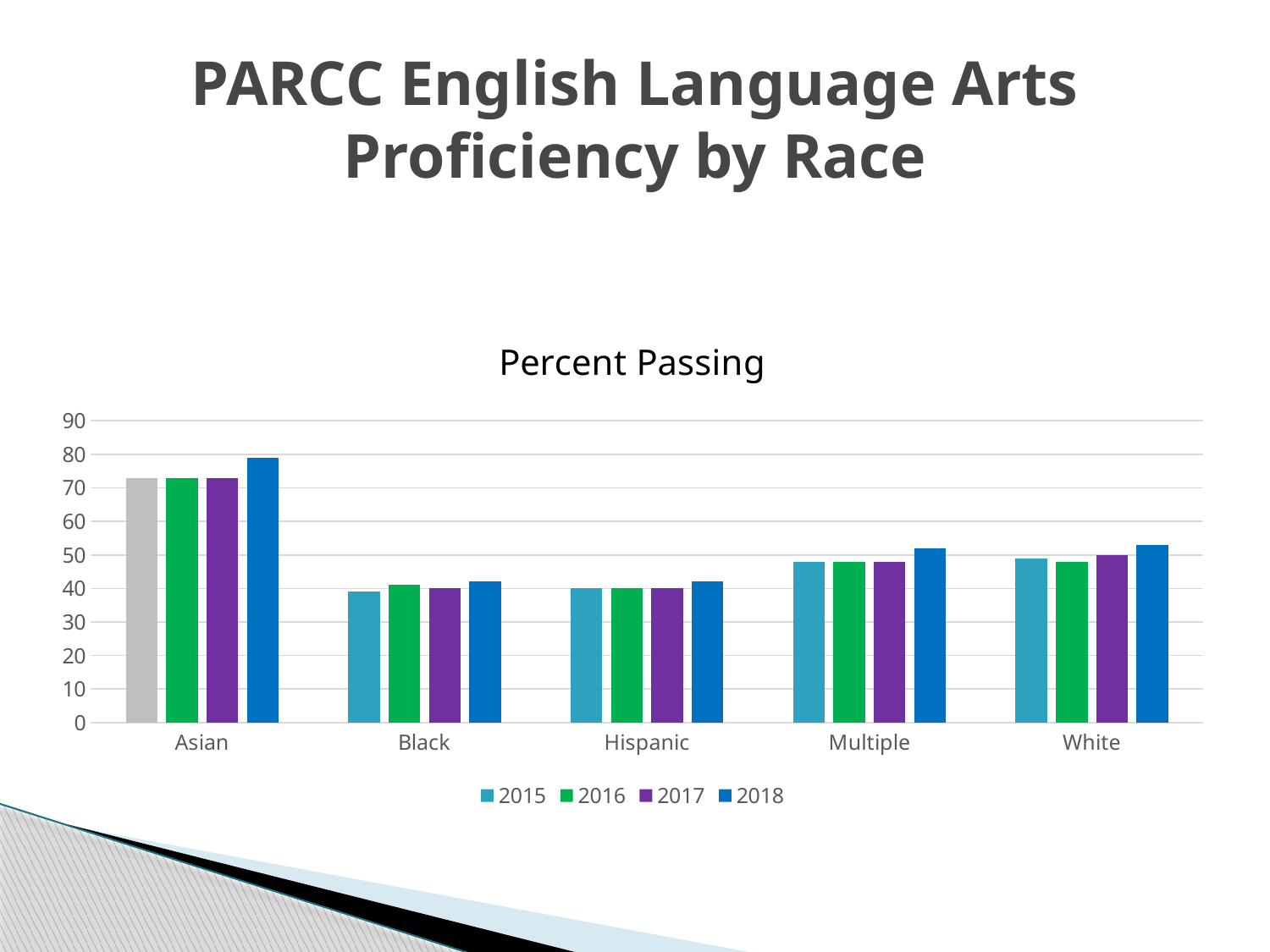
How many series does the legend list? 4 Which race category has the highest percent passing in 2018? Asian Is the 2018 value for Hispanic greater or less than 50? less What is the title of the chart? Percent Passing Is the 2016 value for Black greater or less than 50? less What kind of chart is shown on the slide? bar chart Which years are listed in the legend? 2015, 2016, 2017, 2018 Which is larger, the 2018 value for Asian or the 2018 value for White? Asian How many race categories are shown on the x axis? 5 For the Asian category, which year has the highest percent passing? 2018 Is the 2018 value for Asian greater or less than 70? greater